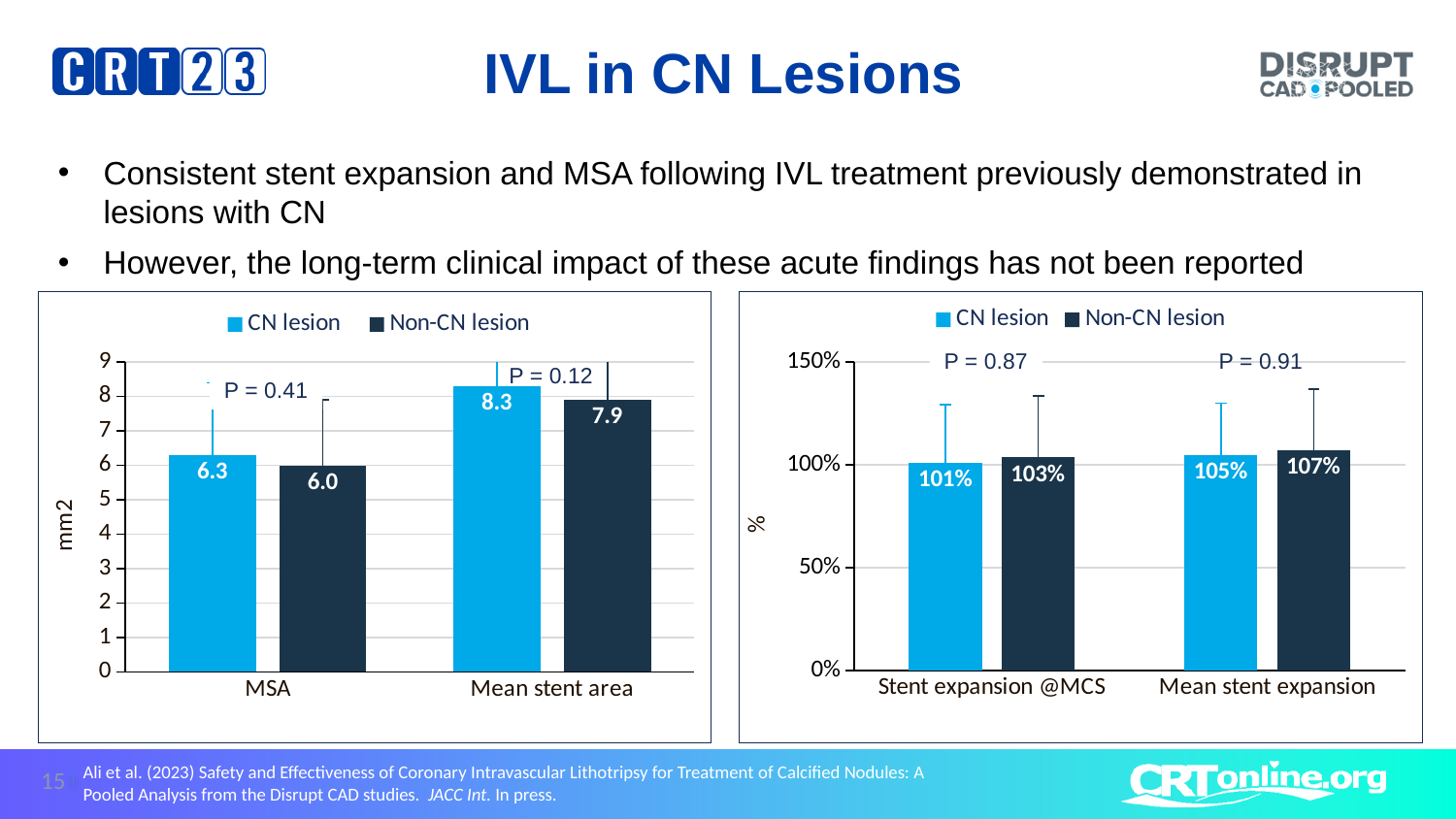
In the left chart, which bar has the highest value? CN lesion, Mean stent area In the right chart, which series has the larger value for Mean stent expansion, CN lesion or Non-CN lesion? Non-CN lesion In the right chart, what is the difference between the Non-CN lesion and CN lesion values for Stent expansion @MCS? 2% In the left chart, what is the MSA value for CN lesion? 6.3 In the right chart, what is the Stent expansion @MCS value for Non-CN lesion? 103% What type of chart is the left chart? Bar chart In the left chart, what is the difference between the CN lesion and Non-CN lesion values for Mean stent area? 0.4 In the right chart, which bar has the lowest value? CN lesion, Stent expansion @MCS In the left chart, what is the Mean stent area value for Non-CN lesion? 7.9 How many series does the legend of the right chart list? 2 In the right chart, what is the Mean stent expansion value for CN lesion? 105% In the left chart, which series has the larger value for MSA, CN lesion or Non-CN lesion? CN lesion